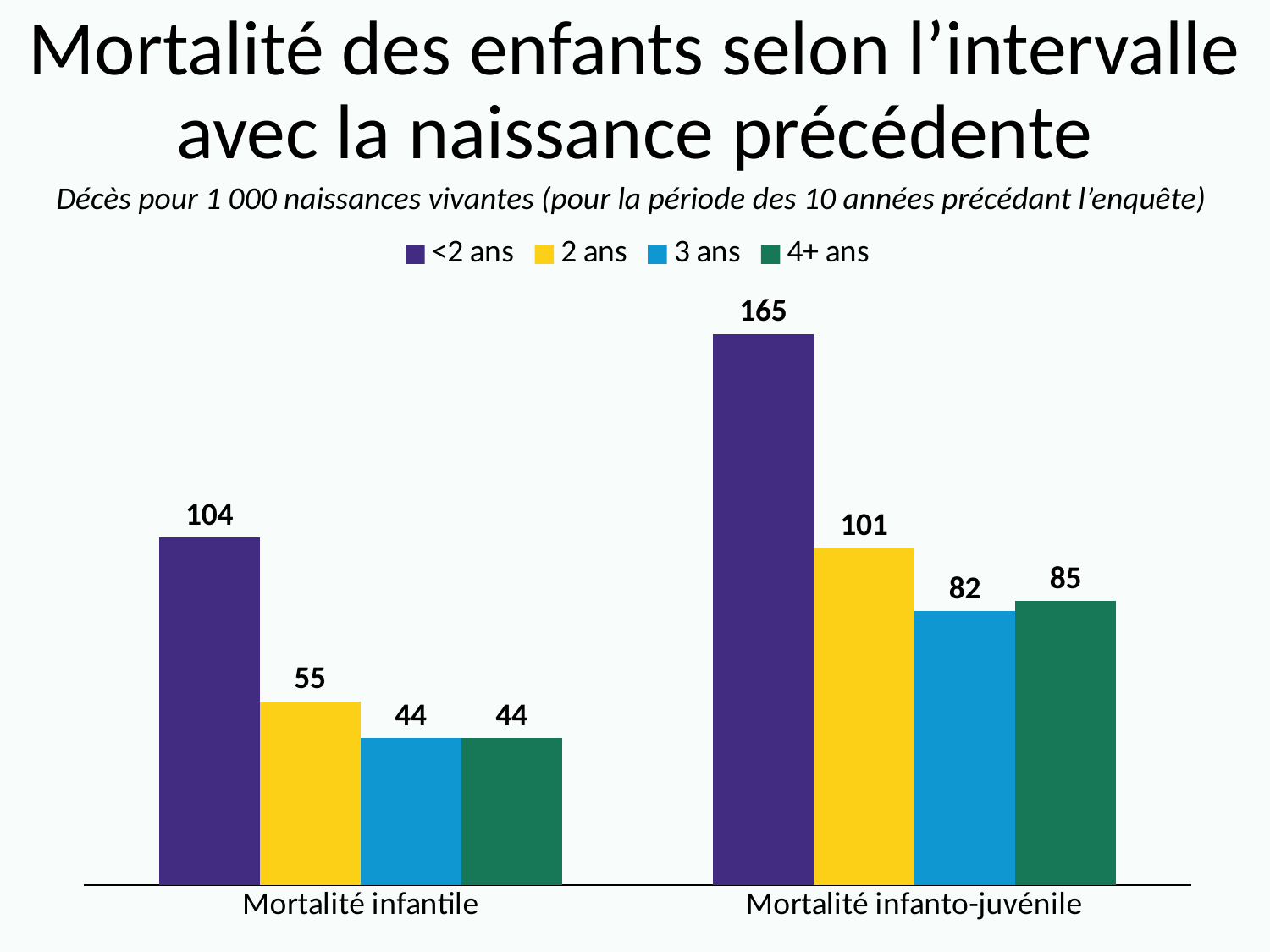
What is the value for '<2 ans' in the 'Mortalité infantile' category? 104 Which series has the lowest value in the 'Mortalité infanto-juvénile' category? 3 ans Which series has the highest value in the 'Mortalité infanto-juvénile' category? <2 ans What is the value for '2 ans' in the 'Mortalité infanto-juvénile' category? 101 What kind of chart is shown on the slide? Bar chart What is the difference between the '<2 ans' and '2 ans' values in the 'Mortalité infantile' category? 49 What is the value for '3 ans' in the 'Mortalité infanto-juvénile' category? 82 What is the value for '4+ ans' in the 'Mortalité infantile' category? 44 What is the difference between the '<2 ans' values for 'Mortalité infanto-juvénile' and 'Mortalité infantile'? 61 How many categories are shown on the x axis? 2 Which is larger: the '4+ ans' value for 'Mortalité infanto-juvénile' or the '3 ans' value for 'Mortalité infanto-juvénile'? 4+ ans How many series does the legend list? 4